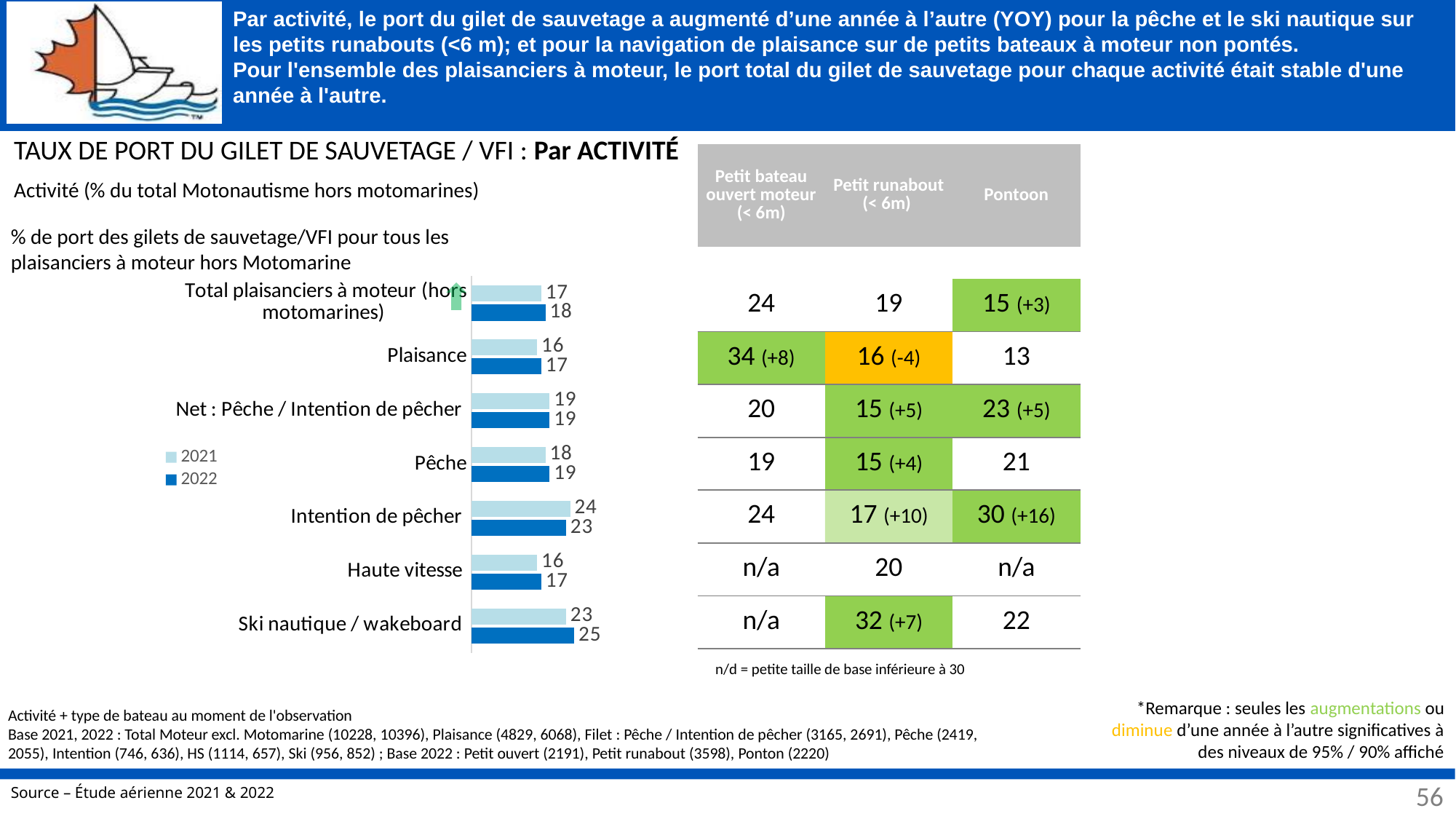
How many activity categories are plotted in the bar chart? 7 Which category has the highest 2021 value? Intention de pêcher Which is larger for Intention de pêcher: the 2021 value or the 2022 value? 2021 Which series is shown in light blue in the legend? 2021 What is the 2021 value for Intention de pêcher? 24 What is the 2022 value for Ski nautique / wakeboard? 25 What is the 2022 value for Plaisance? 17 What is the 2021 value for Total plaisanciers à moteur (hors motomarines)? 17 How many series does the chart legend list? 2 What is the difference between the 2022 and 2021 values for Ski nautique / wakeboard? 2 Which category has the highest 2022 value? Ski nautique / wakeboard What type of chart is shown on the slide? bar chart